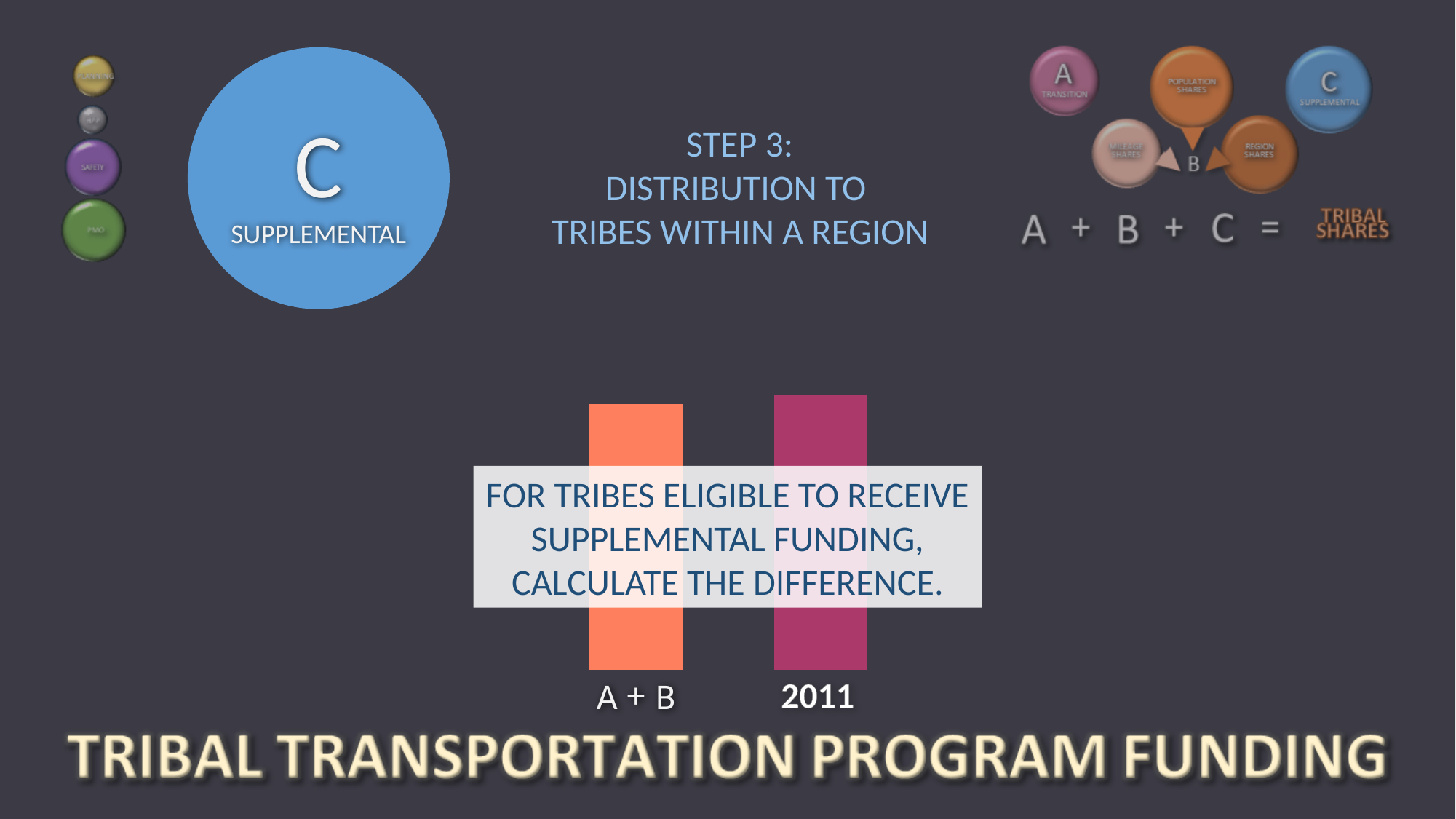
What kind of chart is shown in the middle of the slide? bar chart What colour is the bar labelled 2011? magenta Which bar is taller, A + B or 2011? 2011 Which category has the lowest bar in the chart? A + B Which category has the highest bar in the chart? 2011 How many bars are shown in the chart? 2 What are the labels of the two bars in the chart? A + B and 2011